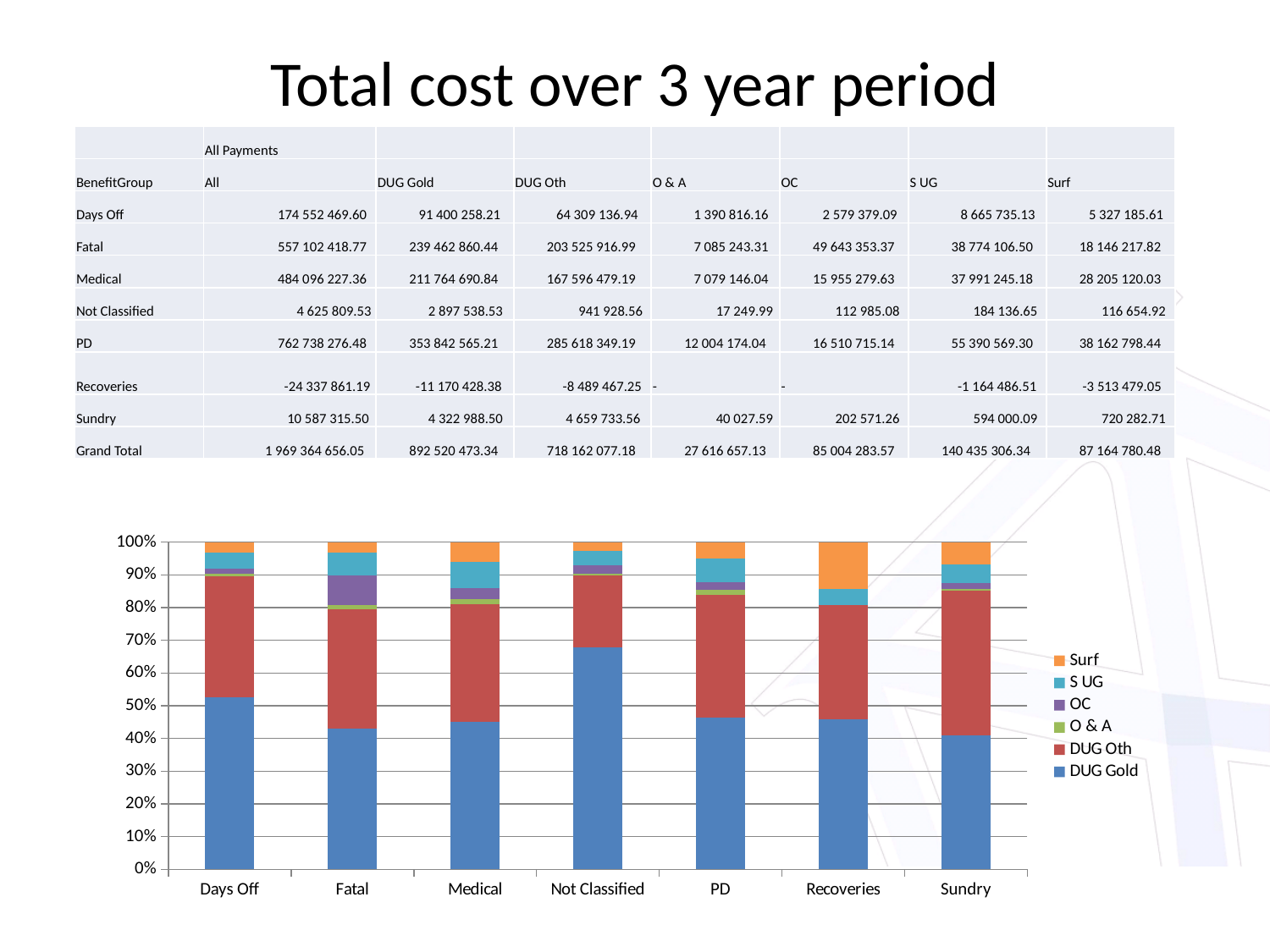
Which category has the largest Surf share in the chart? Recoveries How many categories are shown on the x axis of the chart? 7 Which series is listed first (at the top) in the chart legend? Surf Which category has the largest DUG Gold share in the chart? Not Classified Is the DUG Gold share for Medical greater or less than 50%? less How many series does the chart legend list? 6 What is the highest value shown on the chart's y axis? 100% Is the DUG Gold share for Fatal greater or less than 50%? less Is the DUG Gold share for Not Classified greater or less than 60%? greater What kind of chart is shown on the slide? Stacked bar chart Which has the larger DUG Gold share, Not Classified or Fatal? Not Classified